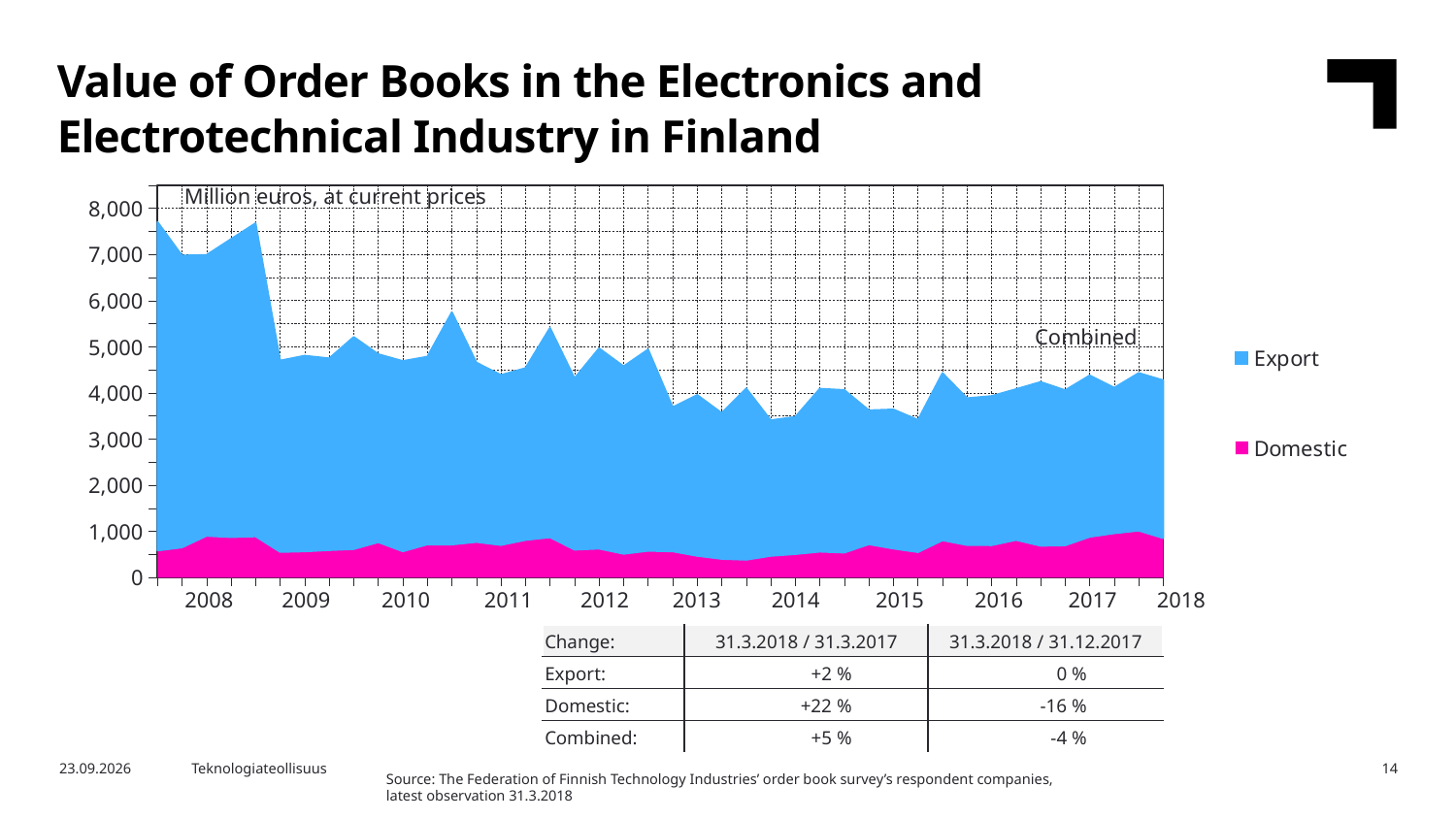
How many year labels are shown on the x axis? 11 Is the combined value of order books around 2010 greater or less than 4,000? greater In which year does the combined value of order books reach its highest level? 2008 What are the two series named in the chart legend? Export and Domestic Is the Domestic value at the 2018 end of the chart greater or less than 2,000? less Which series, Export or Domestic, has the larger values throughout the chart? Export Is the combined value of order books at the start of 2008 greater or less than 7,000? greater How many series does the chart legend list? 2 Does the combined value of order books rise or fall overall from 2008 to 2018? Fall What unit is stated at the top of the chart area? Million euros, at current prices What kind of chart is shown on the slide? Area chart